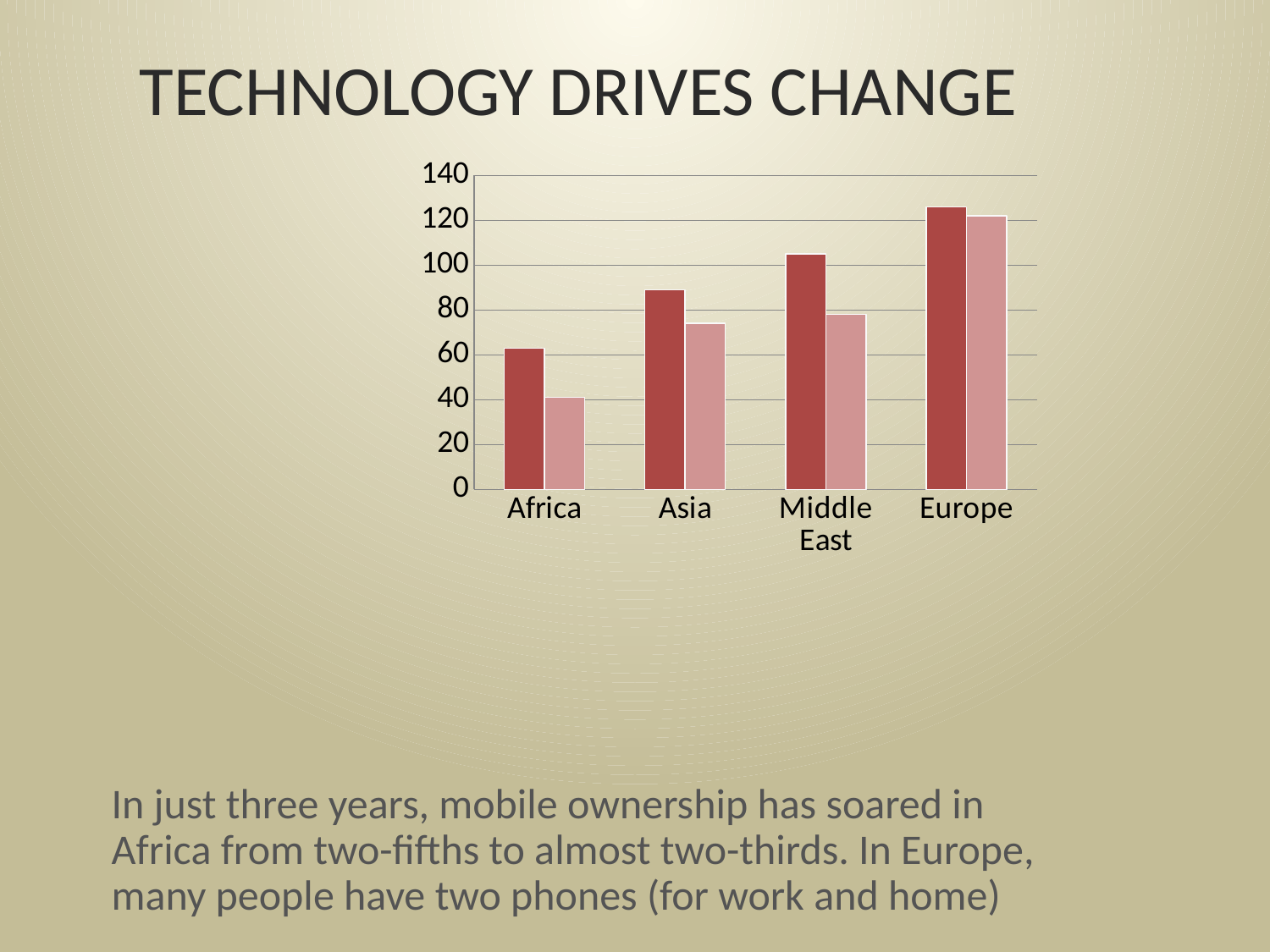
Is the dark red bar for Middle East greater or less than 100? greater What kind of chart is shown on the slide? bar chart Do the dark red bars rise or fall from Africa to Europe along the x axis? rise Which category has the shortest light pink bar? Africa Is the light pink bar for Africa greater or less than 60? less Which category has the tallest dark red bar? Europe Which category has the shortest dark red bar? Africa Which is larger, the dark red bar for Asia or the dark red bar for Middle East? Middle East How many bars are plotted for each category in the chart? 2 How many categories are shown on the x axis of the chart? 4 Is the light pink bar for Asia greater or less than 80? less